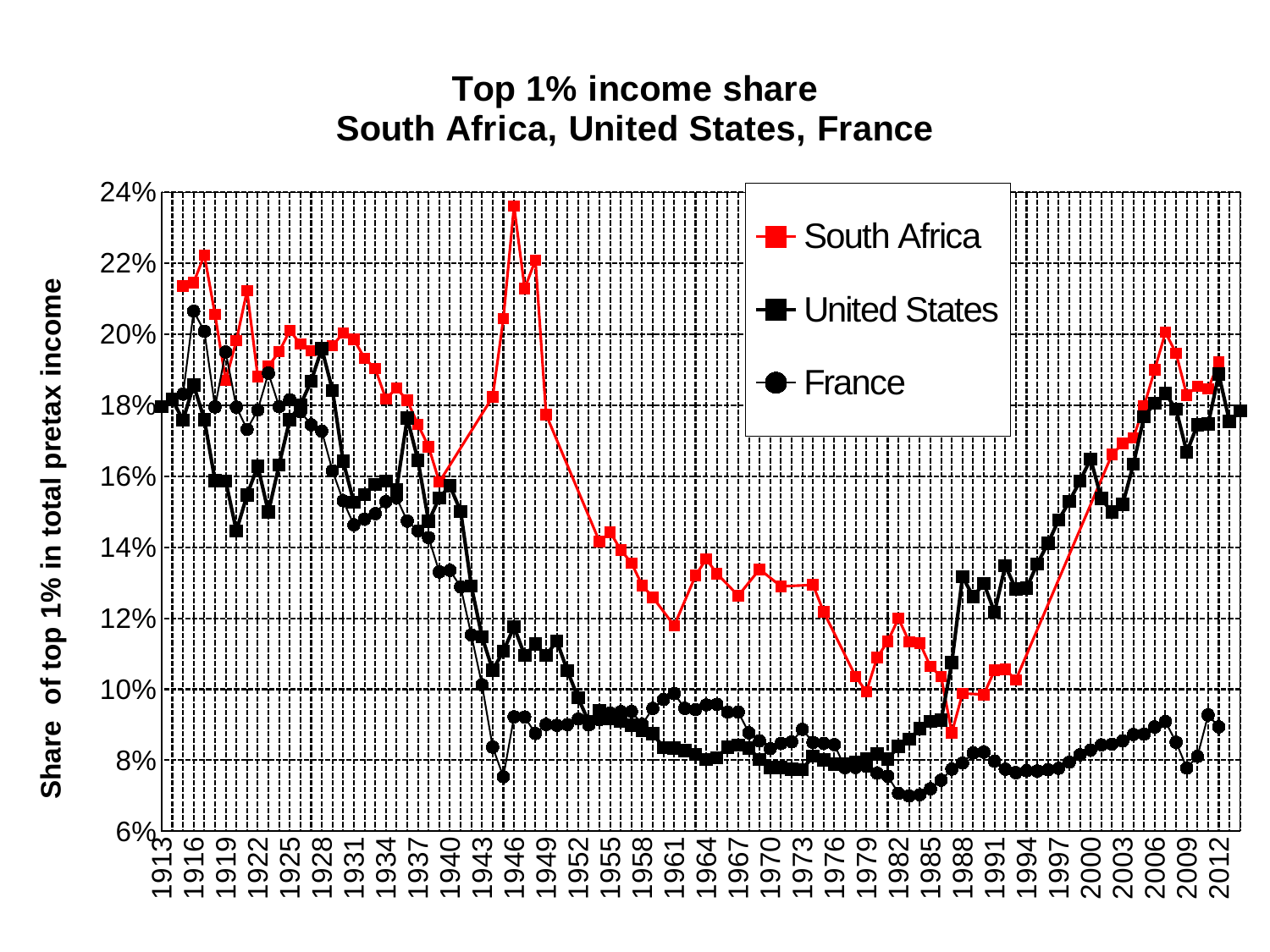
Is the value for South Africa in 1946 greater or less than 22%? greater What kind of chart is shown on the slide? line chart Which series is drawn with red square markers? South Africa Does the value for South Africa rise or fall from 1988 to 2006? rise Is the value for France in 1982 greater or less than 8%? less How many series does the legend list? 3 Which series has the lowest value in 2012? France What is the title of the chart? Top 1% income share South Africa, United States, France Which series has the highest value in 1946? South Africa In 1991, which is larger: the value for the United States or the value for South Africa? United States Is the value for France in 1916 greater or less than 20%? greater